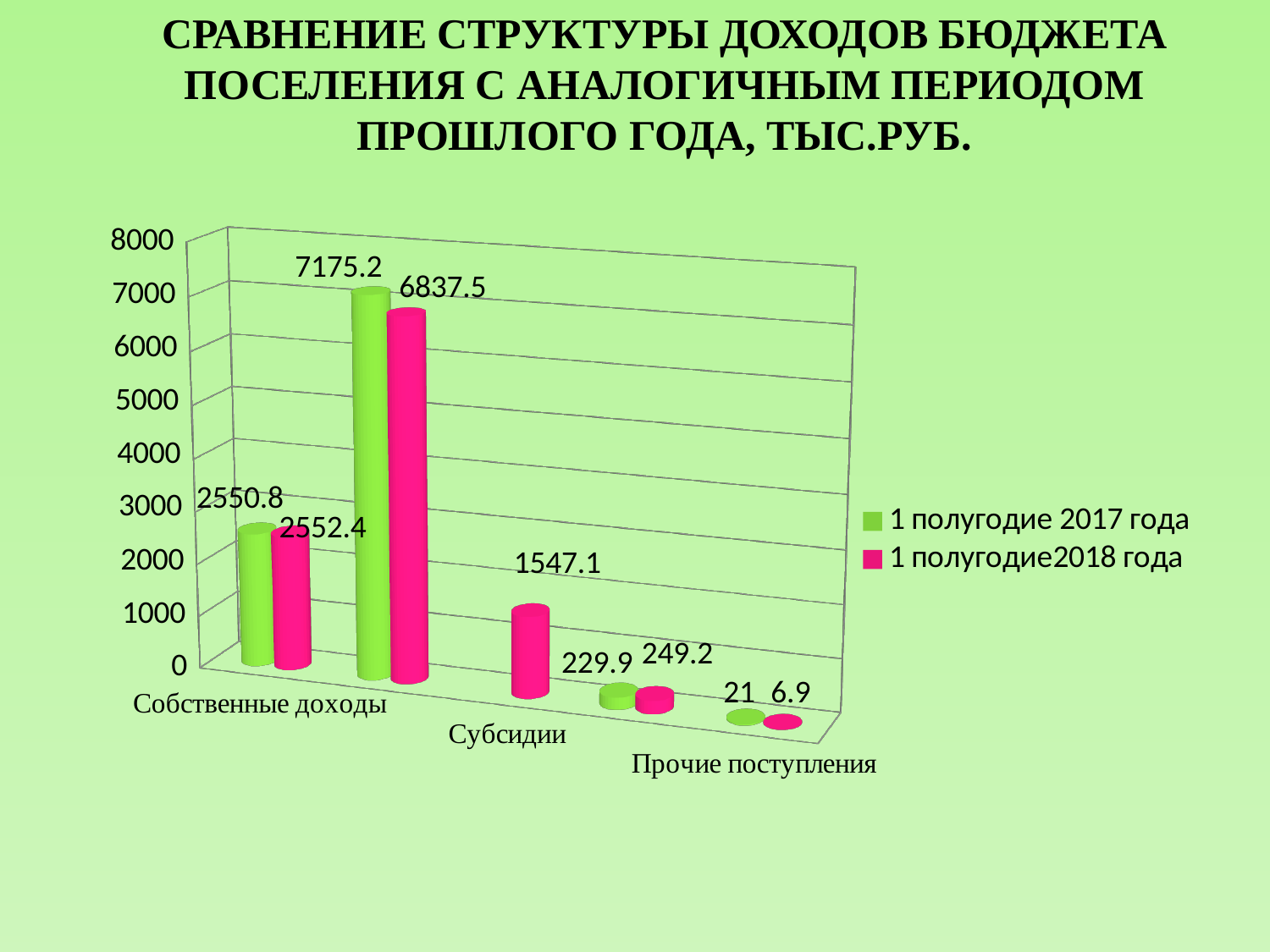
Which colour represents the series 1 полугодие 2018 года in the legend? pink What is the difference between the highest 2017 value (7175.2) and the highest 2018 value (6837.5)? 337.7 What is the lowest value shown for the series 1 полугодие 2017 года? 21 What is the highest value shown for the series 1 полугодие 2017 года? 7175.2 What kind of chart is shown on the slide? bar chart How many series does the legend list? 2 What is the difference between the two values for Прочие поступления (21 and 6.9)? 14.1 What is the value for Собственные доходы in 1 полугодие 2017 года? 2550.8 What is the value for Собственные доходы in 1 полугодие 2018 года? 2552.4 What is the highest value shown for the series 1 полугодие 2018 года? 6837.5 For Прочие поступления, which series has the larger value: 1 полугодие 2017 года or 1 полугодие 2018 года? 1 полугодие 2017 года What is the lowest value shown for the series 1 полугодие 2018 года? 6.9